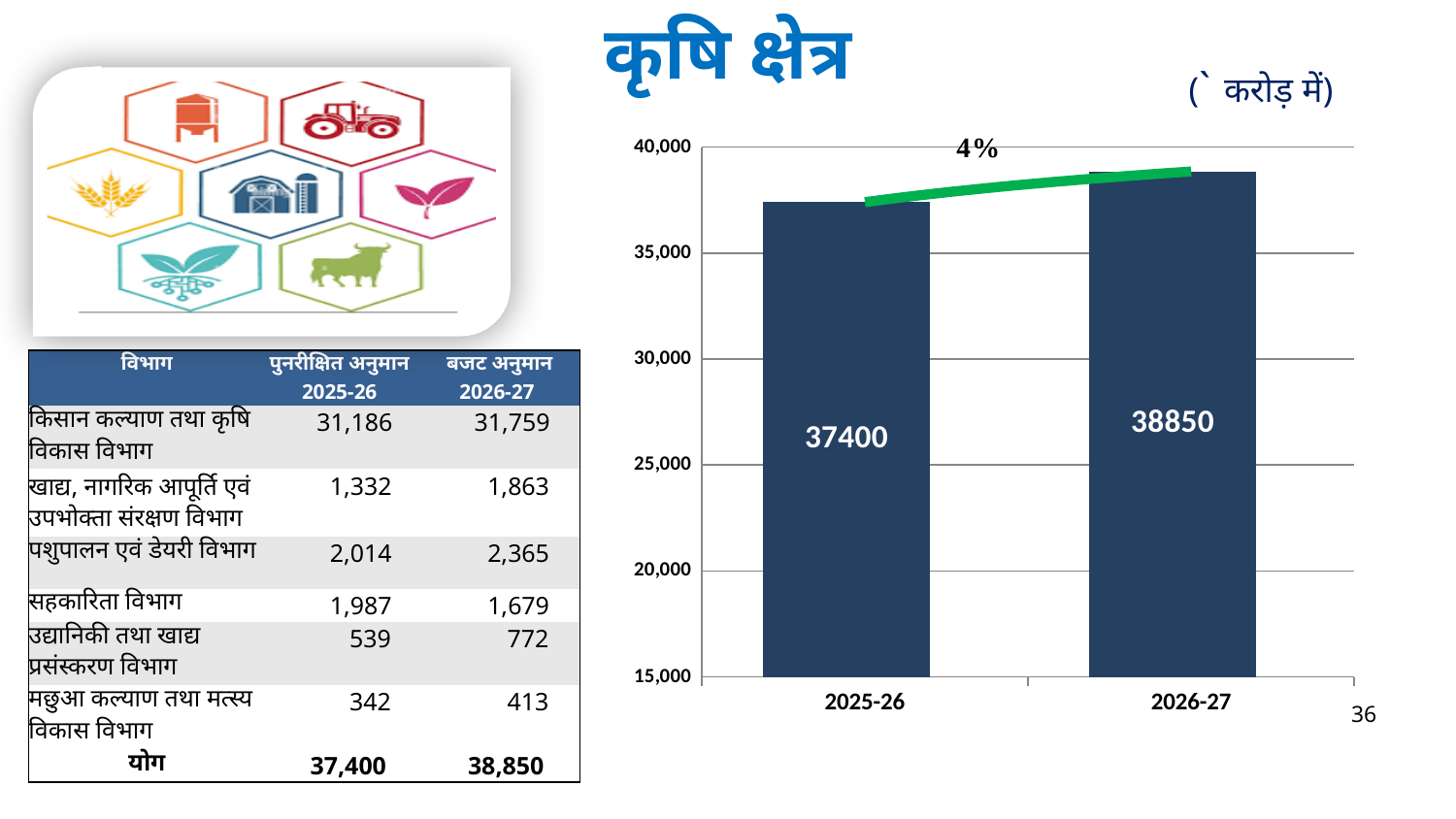
How many bars are plotted in the chart? 2 What is the title of the chart on the slide? कृषि क्षेत्र What kind of chart is shown on the slide? bar chart What percentage growth is annotated above the bars in the chart? 4% Which year has the higher bar in the chart? 2026-27 Do the values rise or fall from 2025-26 to 2026-27? rise What is the value of the bar for 2025-26? 37400 Is the value for 2026-27 greater or less than 40,000? less What is the value of the bar for 2026-27? 38850 What is the difference between the 2026-27 value and the 2025-26 value? 1450 Is the value for 2025-26 greater or less than 35,000? greater Which year has the lower bar in the chart? 2025-26